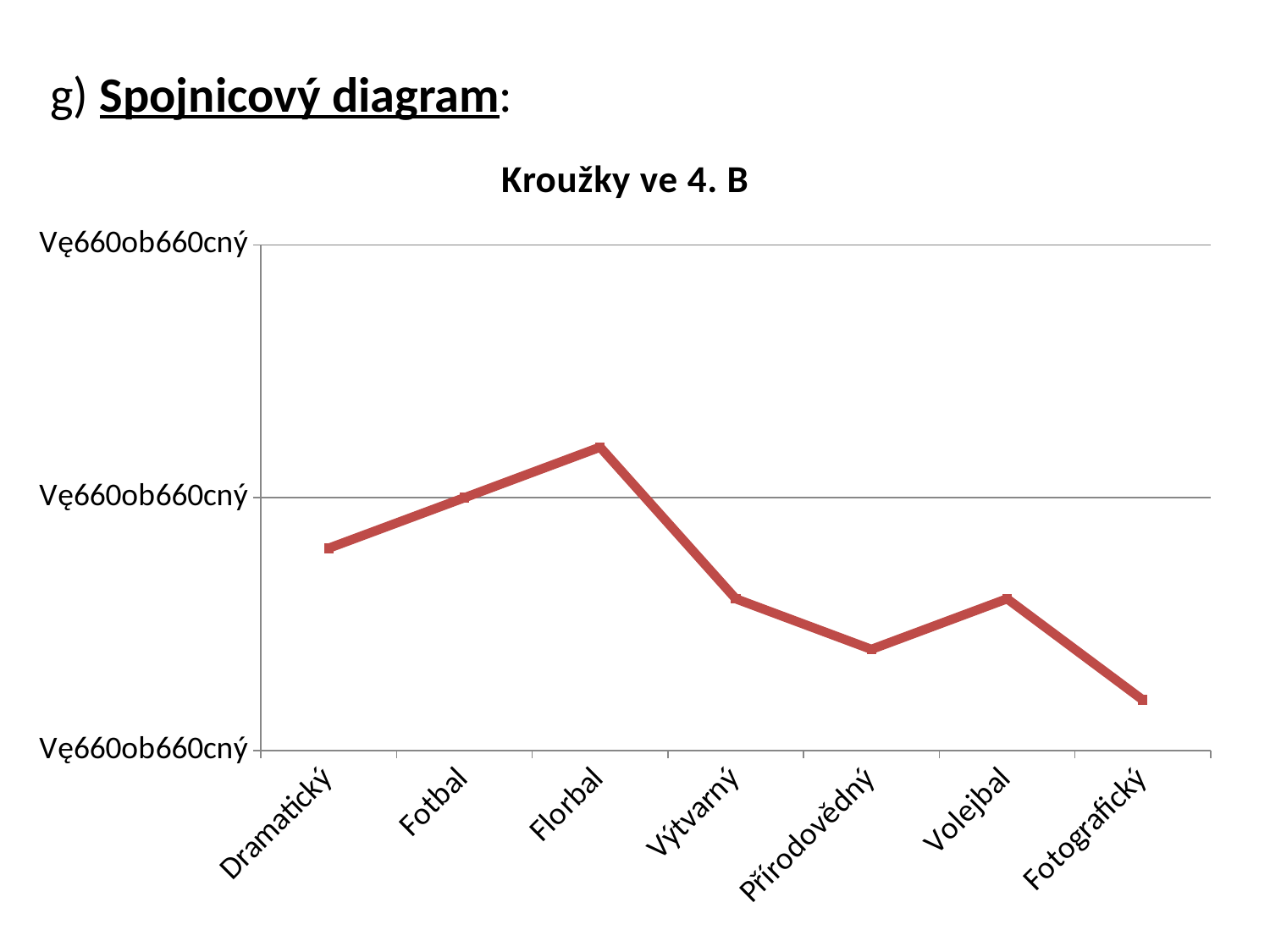
Does the line rise or fall from Florbal to Výtvarný? Falls How many categories are plotted along the x axis of the chart? 7 What is the title of the chart? Kroužky ve 4. B Which category has the lowest value in the chart? Fotografický Which has the higher value, Fotbal or Dramatický? Fotbal Which category has the highest value in the chart? Florbal Does the line rise or fall from Volejbal to Fotografický? Falls Which has the higher value, Přírodovědný or Fotografický? Přírodovědný What kind of chart is shown on the slide? Line chart Does the line rise or fall from Dramatický to Florbal? Rises What colour is the line in the chart? Red Which has the higher value, Florbal or Volejbal? Florbal